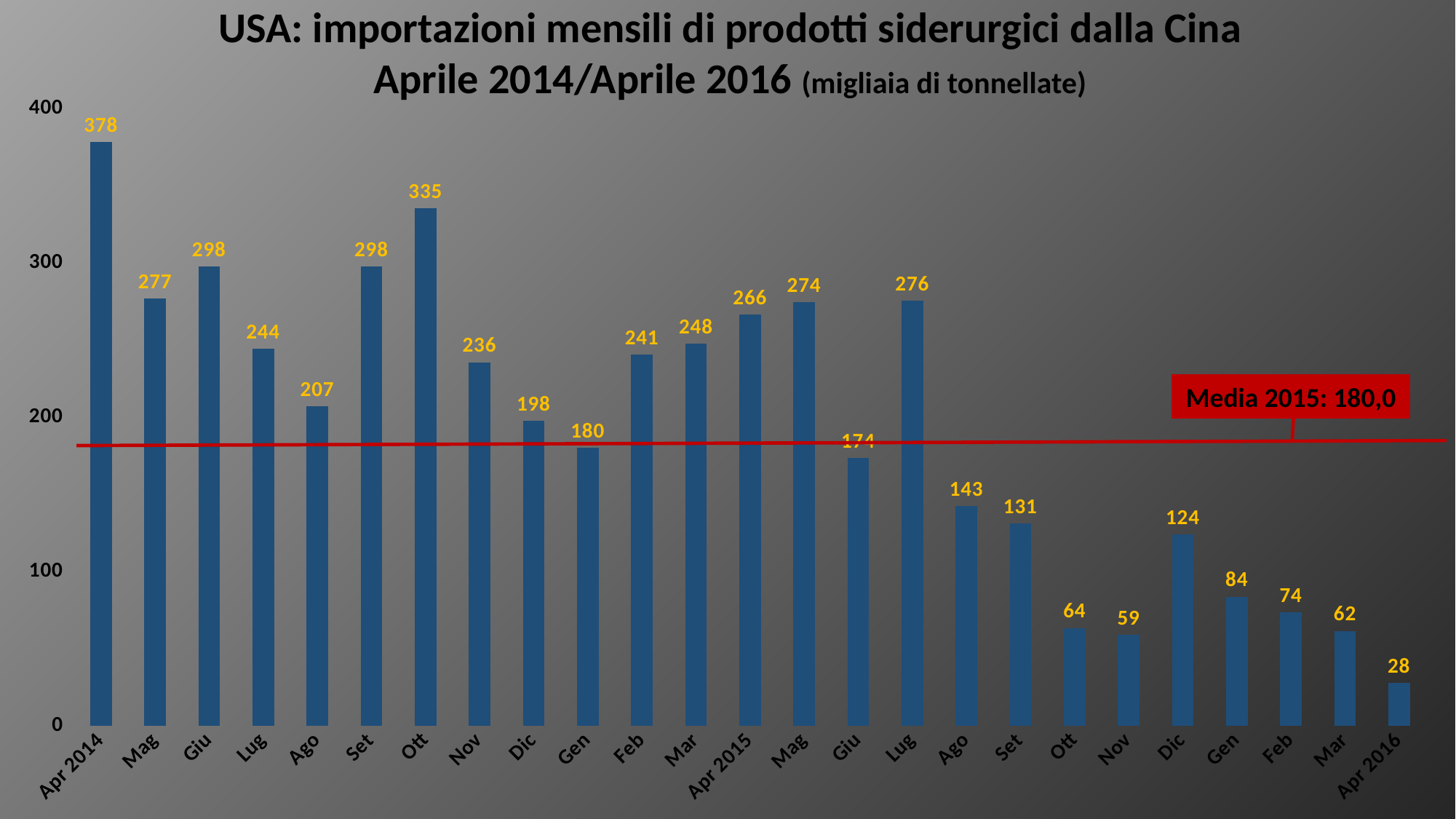
What value does the red horizontal line labelled 'Media 2015' represent? 180,0 Do the values generally rise or fall from Apr 2015 to Apr 2016? Fall What is the value for Apr 2016? 28 What is the value for Apr 2015? 266 Which is larger, the value for Apr 2015 or the value for Apr 2014? Apr 2014 What is the value for the Ott bar that comes before Apr 2015 (Ott 2014)? 335 Which month has the highest value? Apr 2014 Which month has the lowest value? Apr 2016 What kind of chart is shown on the slide? Bar chart What is the difference between the values for Apr 2014 and Apr 2016? 350 How many monthly bars are plotted in the chart? 25 What is the value for Apr 2014? 378